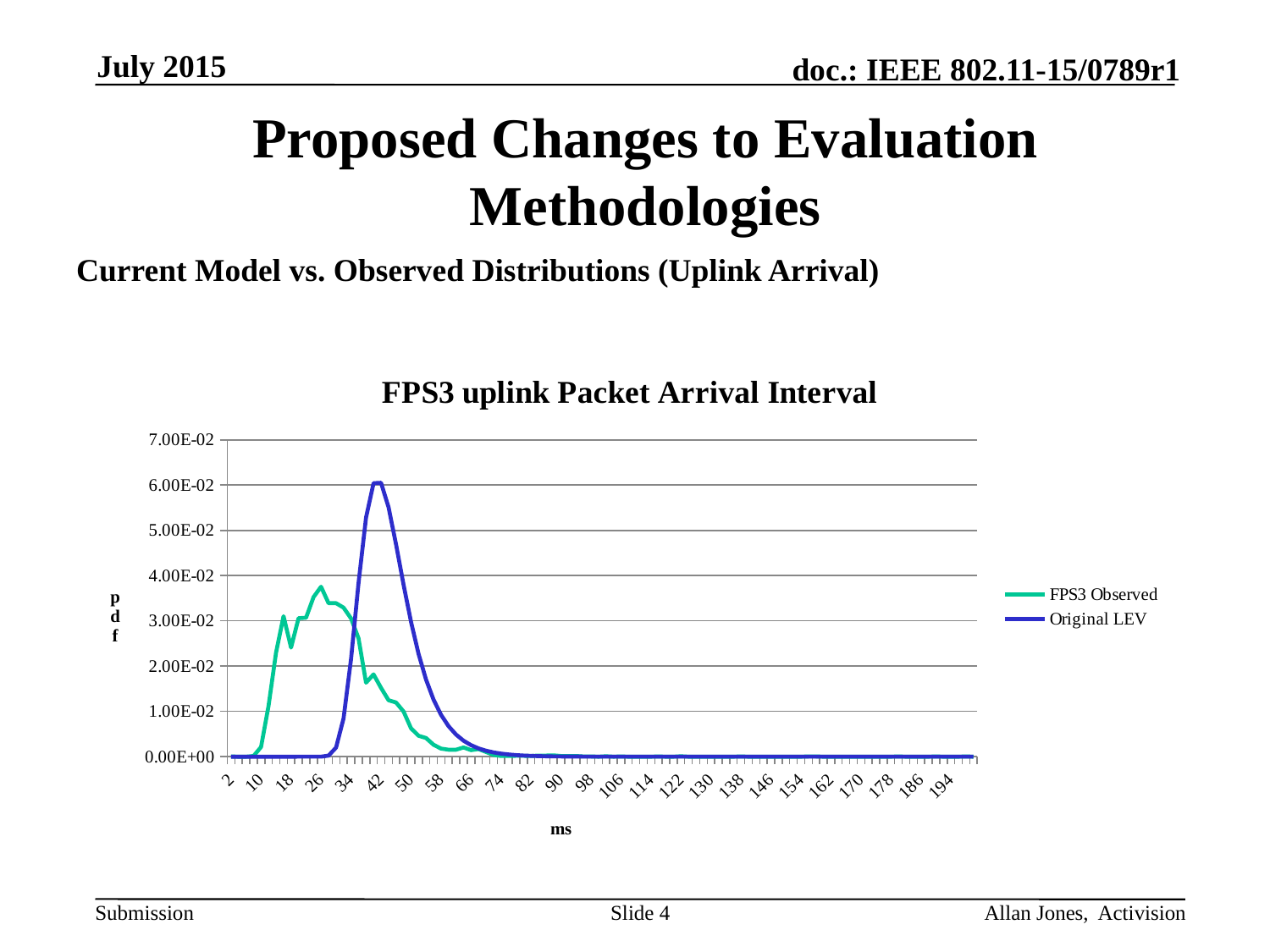
Does the Original LEV series rise or fall between 42 ms and 66 ms? fall Is the value of the Original LEV series at 18 ms greater or less than 1.00E-02? less Is the peak value of the Original LEV series greater or less than 5.00E-02? greater Is the value of the FPS3 Observed series at 58 ms greater or less than 1.00E-02? less At 18 ms, which series has the larger value, FPS3 Observed or Original LEV? FPS3 Observed How many series does the legend of the chart list? 2 What kind of chart is shown on the slide? line chart Which series reaches the higher peak value, FPS3 Observed or Original LEV? Original LEV At 42 ms, which series has the larger value, FPS3 Observed or Original LEV? Original LEV What is the title of the chart? FPS3 uplink Packet Arrival Interval What is the label of the x axis of the chart? ms